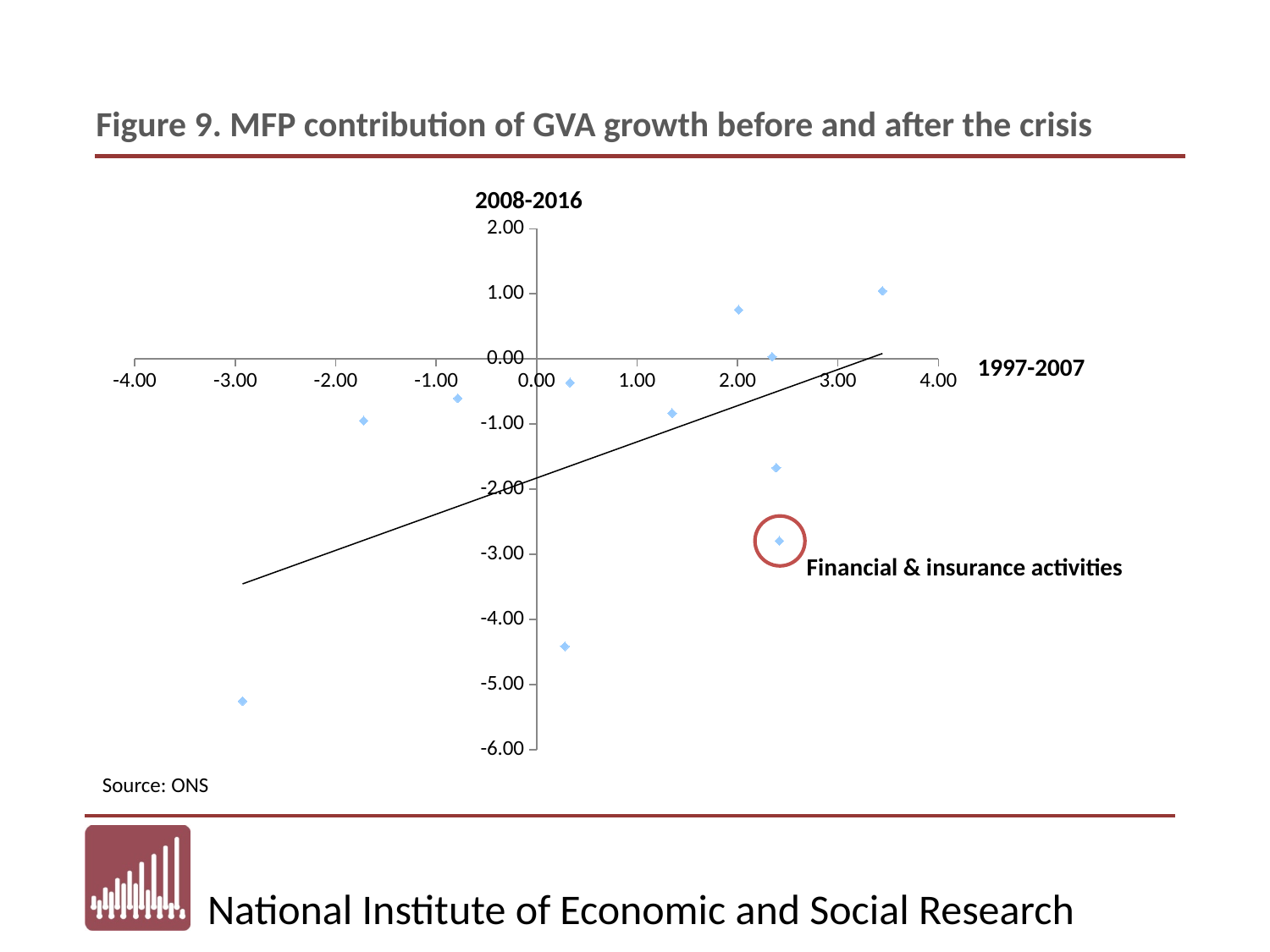
Which point is circled and labelled on the chart? Financial & insurance activities What is the title of the figure on the slide? Figure 9. MFP contribution of GVA growth before and after the crisis How many data points are plotted on the chart? 11 Is the 1997-2007 value for Financial & insurance activities greater or less than 2.00? greater Is the 2008-2016 value for Financial & insurance activities greater or less than -2.00? less Is the 2008-2016 value of the lowest point on the chart greater or less than -5.00? less Does the fitted line on the chart rise or fall as the 1997-2007 value increases? rises What kind of chart is shown on the slide? Scatter chart